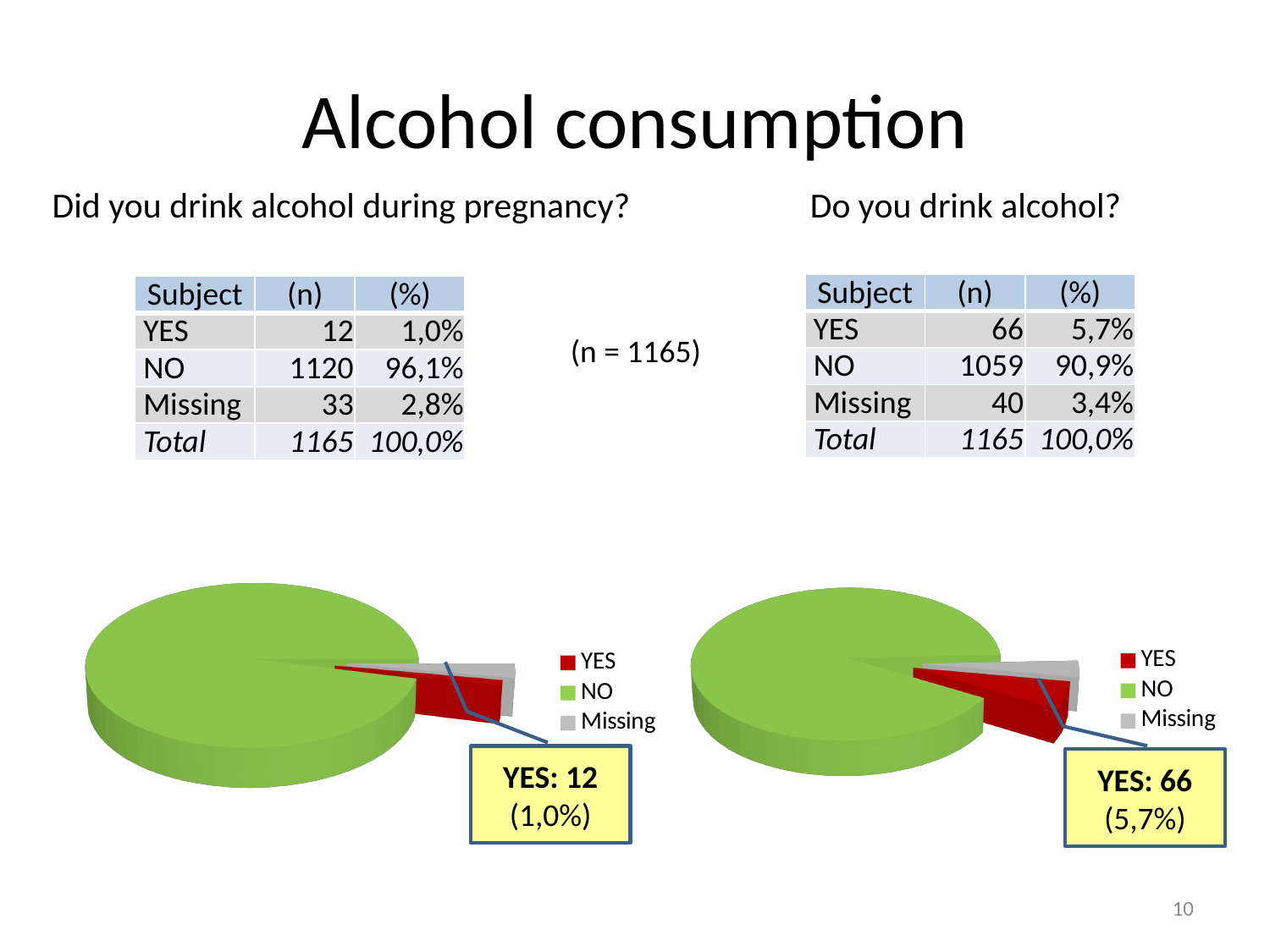
In the left pie chart (Did you drink alcohol during pregnancy?), which category has the largest slice? NO In the right pie chart (Do you drink alcohol?), which category has the smallest slice? Missing In the left pie chart (Did you drink alcohol during pregnancy?), what colour is the YES slice? Red In the left pie chart (Did you drink alcohol during pregnancy?), what share of the pie does the NO slice represent according to the table? 96,1% How many slices does the left pie chart (Did you drink alcohol during pregnancy?) have? 3 Comparing the YES callouts, which pie chart has the larger YES value: the left (pregnancy) or the right (Do you drink alcohol?)? The right (Do you drink alcohol?) In the right pie chart (Do you drink alcohol?), what percentage is shown in the callout for YES? 5,7% How many entries does the legend of the right pie chart (Do you drink alcohol?) list? 3 In the right pie chart (Do you drink alcohol?), what is the difference in count between NO (1059) and YES (66)? 993 In the left pie chart (Did you drink alcohol during pregnancy?), what is the value shown in the callout for YES? 12 What type of charts are shown on the slide? Pie charts In the right pie chart (Do you drink alcohol?), what is the total count across all slices according to the table? 1165